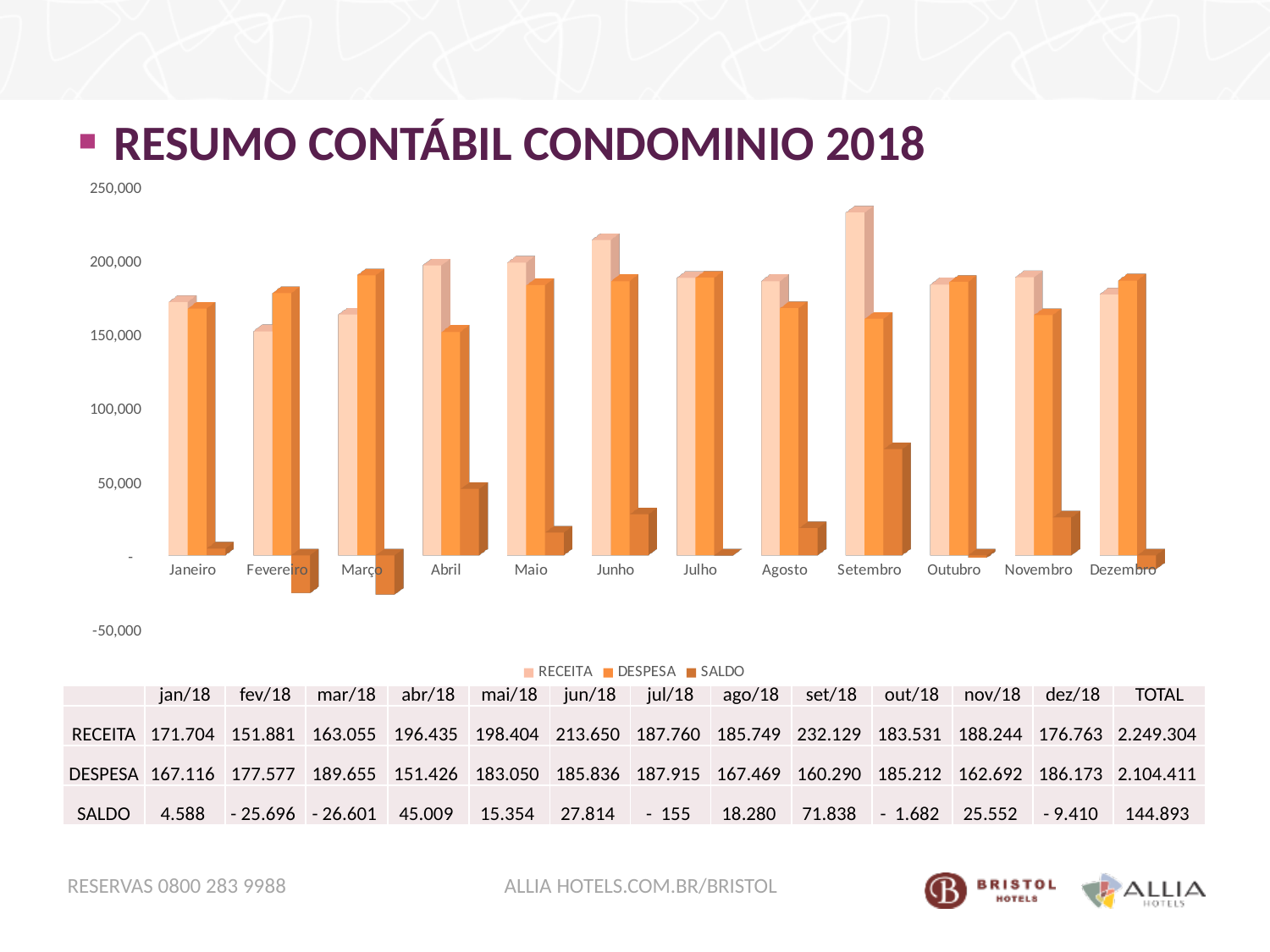
What is the SALDO value for Março (mar/18)? - 26.601 How many series does the chart legend list? 3 How many months are plotted along the x axis of the chart? 12 What is the DESPESA value for Abril (abr/18)? 151.426 What kind of chart is shown on the slide? bar chart Does RECEITA rise or fall from Fevereiro to Junho? rise Which month has the highest RECEITA? Setembro What is the difference between the RECEITA for Junho (213.650) and Julho (187.760)? 25.890 In Abril, which is larger, RECEITA or DESPESA? RECEITA Is the RECEITA value for Fevereiro greater or less than 200,000? less What is the RECEITA value for Setembro (set/18)? 232.129 Which month has the lowest SALDO? Março